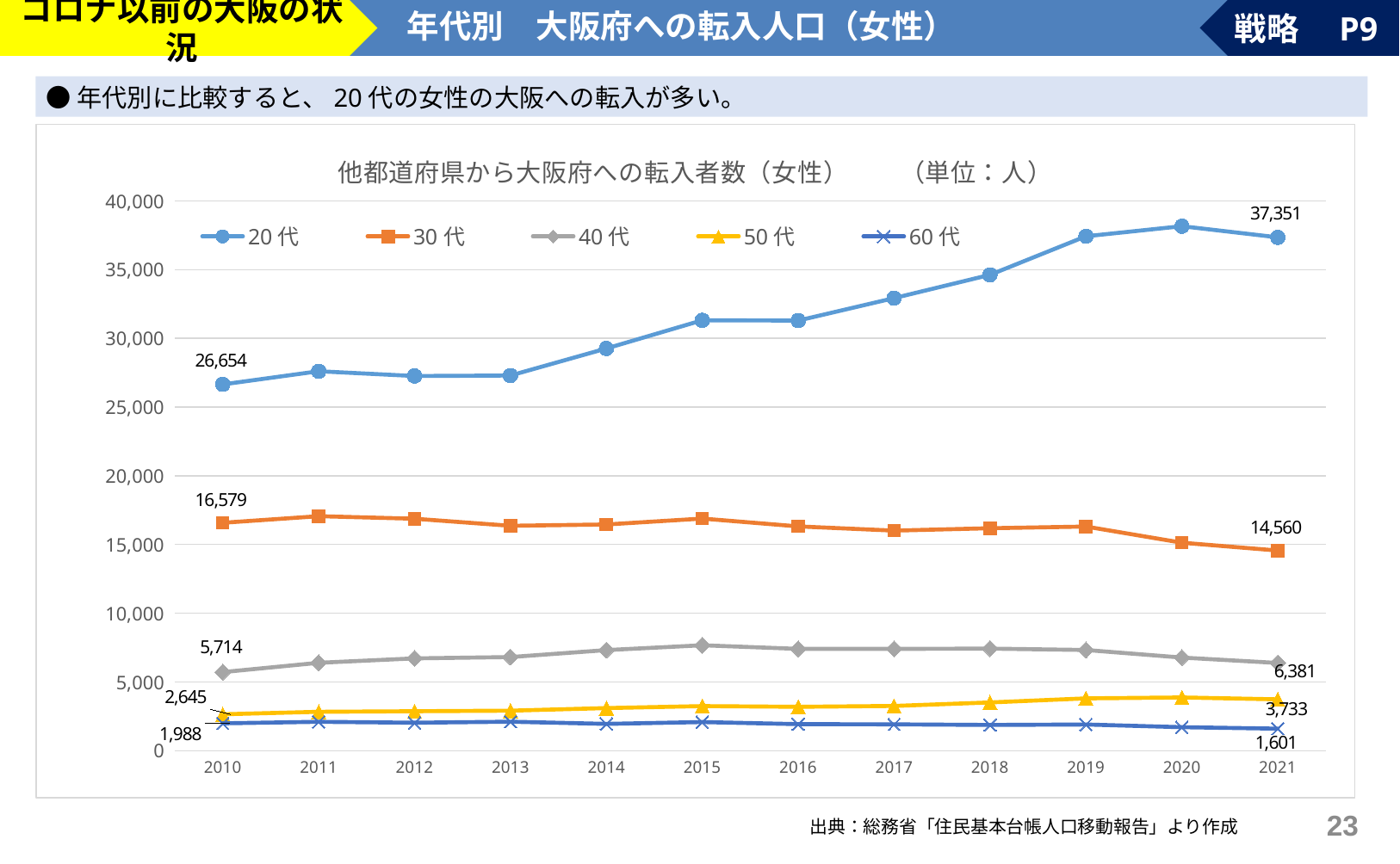
What type of chart is shown on the slide? line chart What is the value for 20代 in 2021? 37,351 Does the 30代 series rise or fall from 2019 to 2021? fall Is the value for 20代 in 2015 greater or less than 30,000? greater How many years are plotted along the x axis? 12 How many series does the legend list? 5 What is the value for 30代 in 2010? 16,579 Which age group has the highest value in 2021? 20代 What is the difference between the 20代 values in 2021 and 2010? 10,697 What is the value for 50代 in 2010? 2,645 Which age group has the lowest value in 2010? 60代 What is the value for 60代 in 2021? 1,601